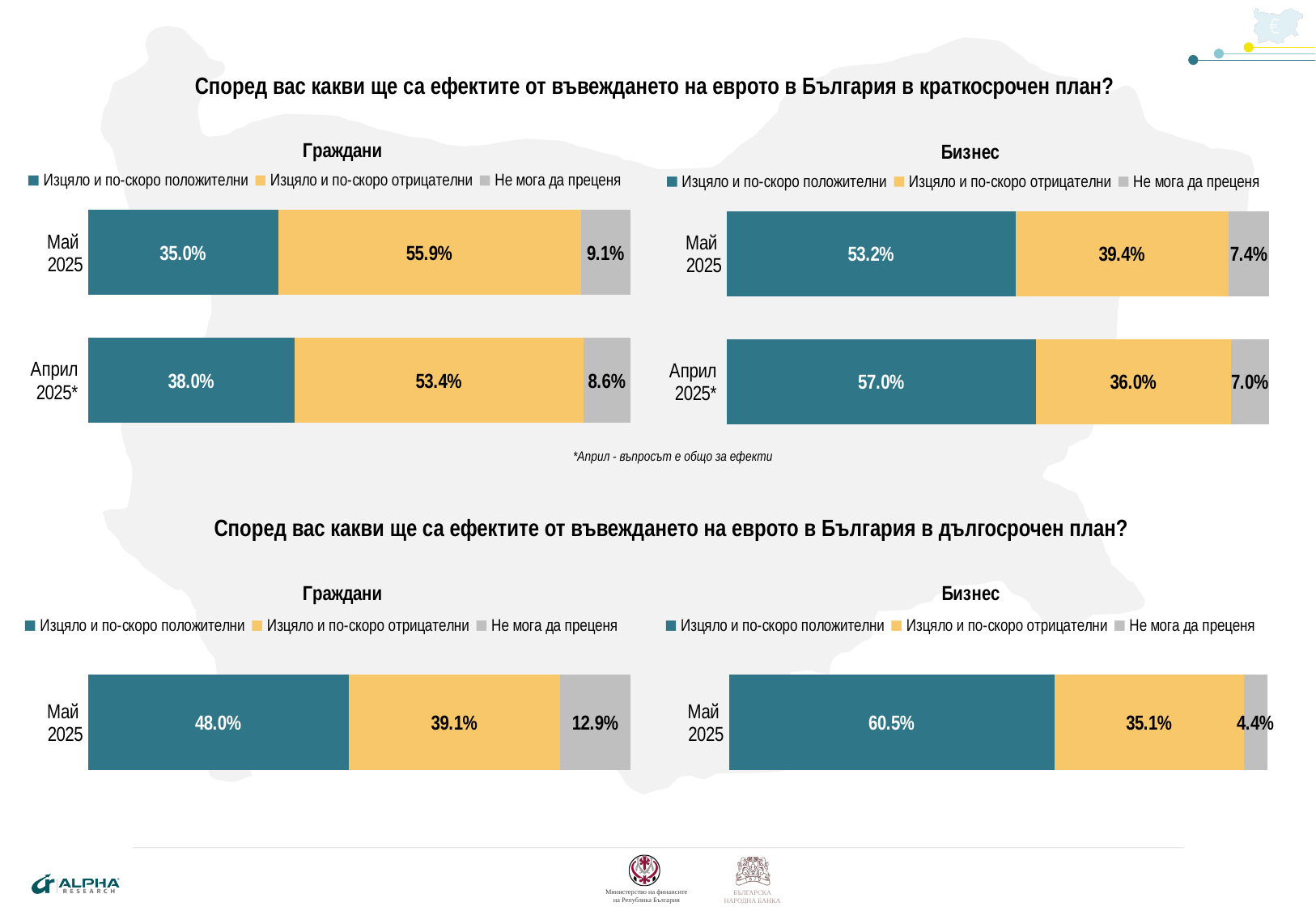
In the long-term chart for Граждани (bottom left), which series has the smallest value in Май 2025? Не мога да преценя In the long-term chart for Бизнес (bottom right), what is the value for Не мога да преценя in Май 2025? 4.4% What kind of chart is the long-term chart for Бизнес (bottom right)? Stacked bar chart In the short-term chart for Граждани (top left), what is the difference between the Изцяло и по-скоро отрицателни values for Май 2025 and Април 2025*? 2.5% How many periods (bars) are shown in the short-term chart for Бизнес (top right)? 2 In the short-term chart for Граждани (top left), what is the value for Изцяло и по-скоро положителни in Май 2025? 35.0% In the short-term chart for Бизнес (top right), what is the difference between the Изцяло и по-скоро положителни value for Май 2025 and the Изцяло и по-скоро отрицателни value for Май 2025? 13.8% In the long-term chart for Граждани (bottom left), what is the value for Изцяло и по-скоро положителни in Май 2025? 48.0% How many series does the legend list in the short-term chart for Граждани (top left)? 3 In the short-term chart for Бизнес (top right), what is the value for Изцяло и по-скоро отрицателни in Април 2025*? 36.0% In the long-term chart for Бизнес (bottom right), which series has the largest value in Май 2025? Изцяло и по-скоро положителни In the short-term chart for Бизнес (top right), which period has the higher value for Изцяло и по-скоро положителни, Май 2025 or Април 2025*? Април 2025*